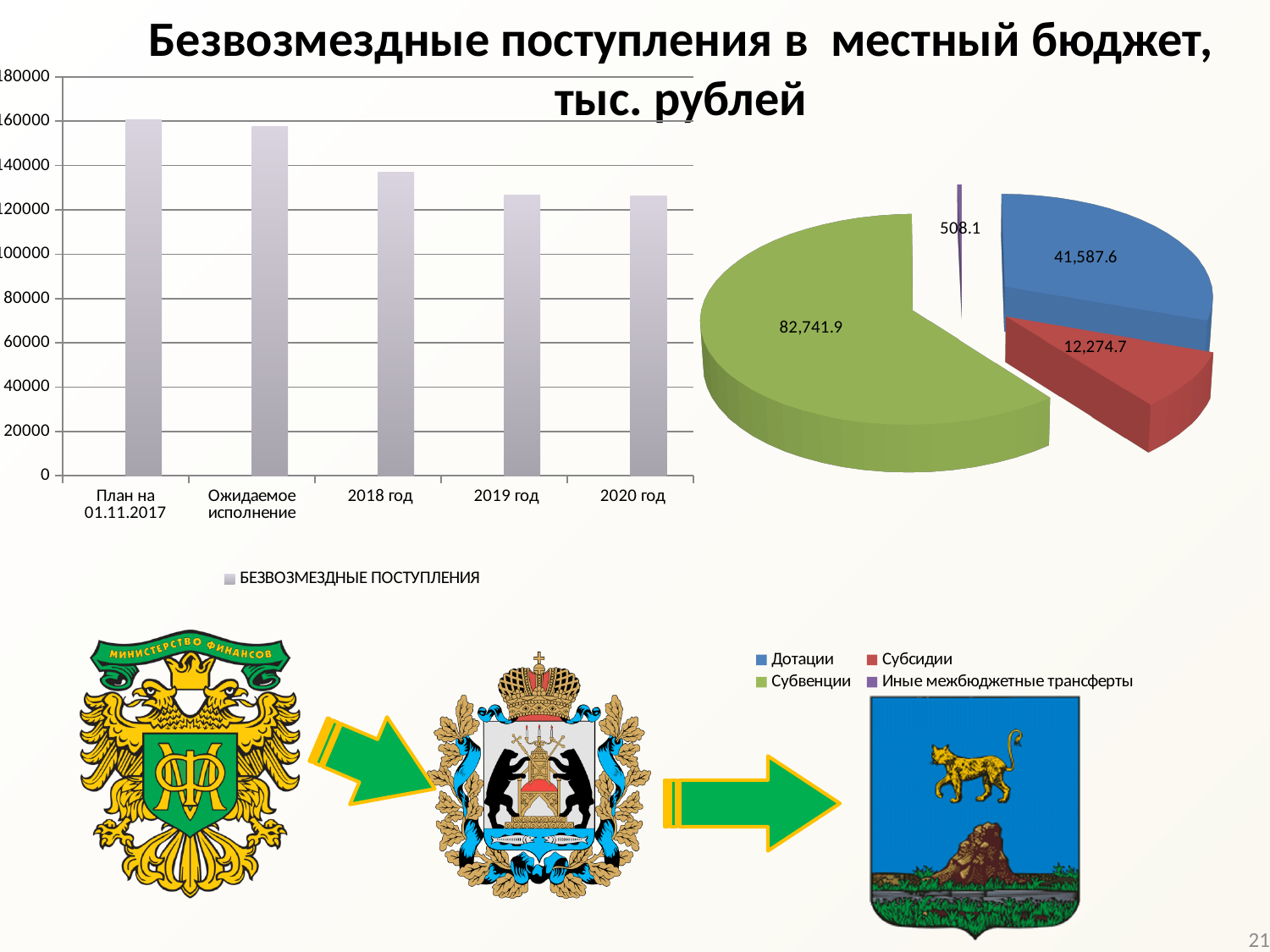
In the pie chart on the right, what is the value for Субсидии? 12,274.7 In the pie chart on the right, which category has the smallest slice? Иные межбюджетные трансферты How many entries does the legend of the pie chart on the right list? 4 How many categories are shown on the x axis of the bar chart on the left? 5 In the bar chart on the left, is the value for План на 01.11.2017 greater or less than 140000? greater In the pie chart on the right, which category has the largest slice? Субвенции In the pie chart on the right, what is the value for Дотации? 41,587.6 In the pie chart on the right, what is the value for Субвенции? 82,741.9 In the bar chart on the left, do the values generally rise or fall from left to right along the x axis? fall What kind of chart is the chart on the left of the slide? Bar chart In the pie chart on the right, what is the value for Иные межбюджетные трансферты? 508.1 In the pie chart on the right, what is the difference between the values for Субвенции and Дотации? 41,154.3